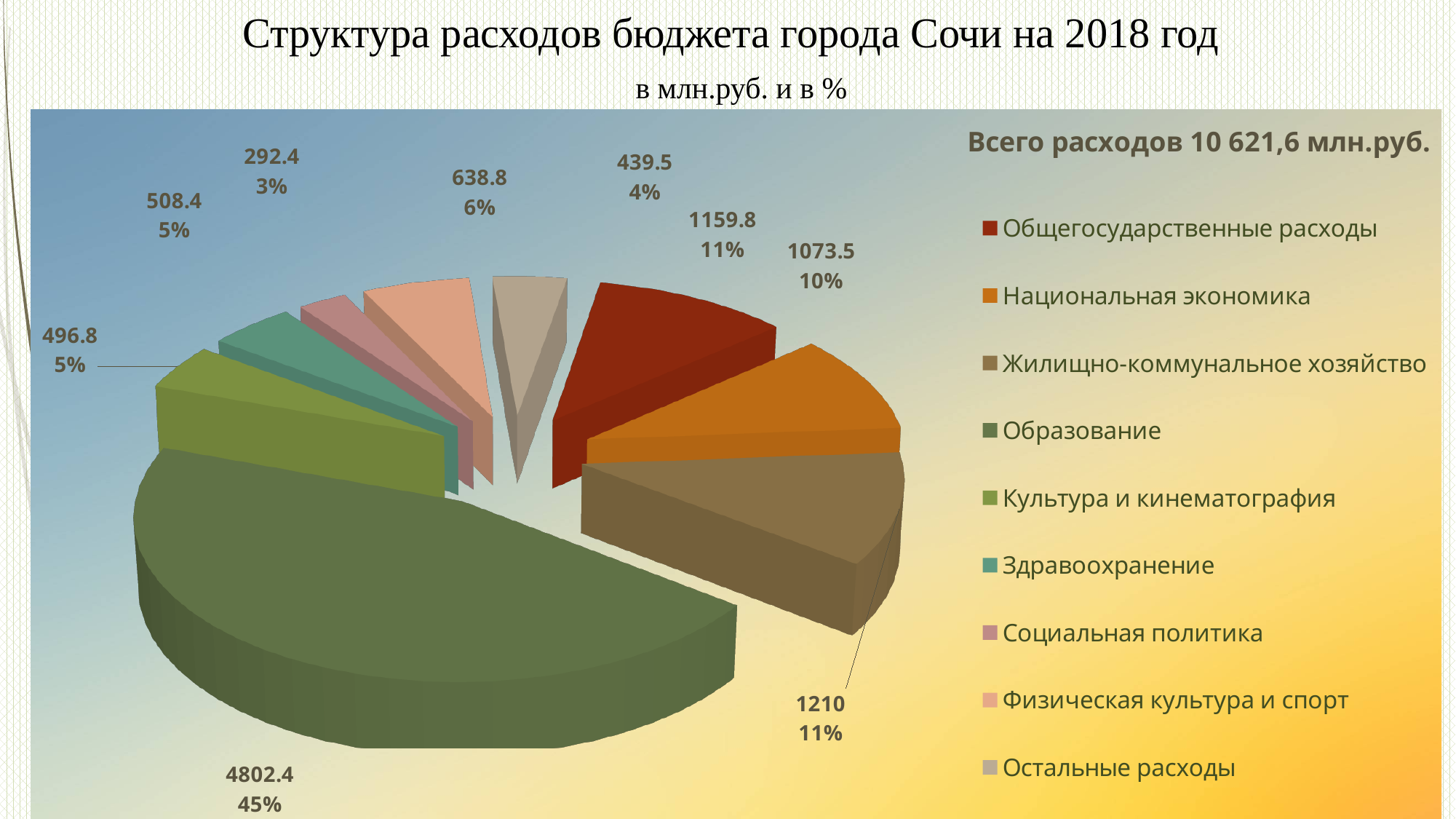
How many categories does the legend list? 9 What is the difference in million rubles between Образование and Жилищно-коммунальное хозяйство? 3592.4 Which is larger: Общегосударственные расходы or Национальная экономика? Общегосударственные расходы Which category has the smallest share of expenses? Социальная политика What share of the budget expenses does Образование account for? 45% Which category has the largest share of expenses? Образование What is the value in million rubles for Образование? 4802.4 What is the value in million rubles for Жилищно-коммунальное хозяйство? 1210 What kind of chart is shown on the slide? pie chart What is the value in million rubles for Общегосударственные расходы? 1159.8 What total expenses figure is stated on the slide? 10 621,6 млн.руб. What percentage share is shown for Национальная экономика? 10%